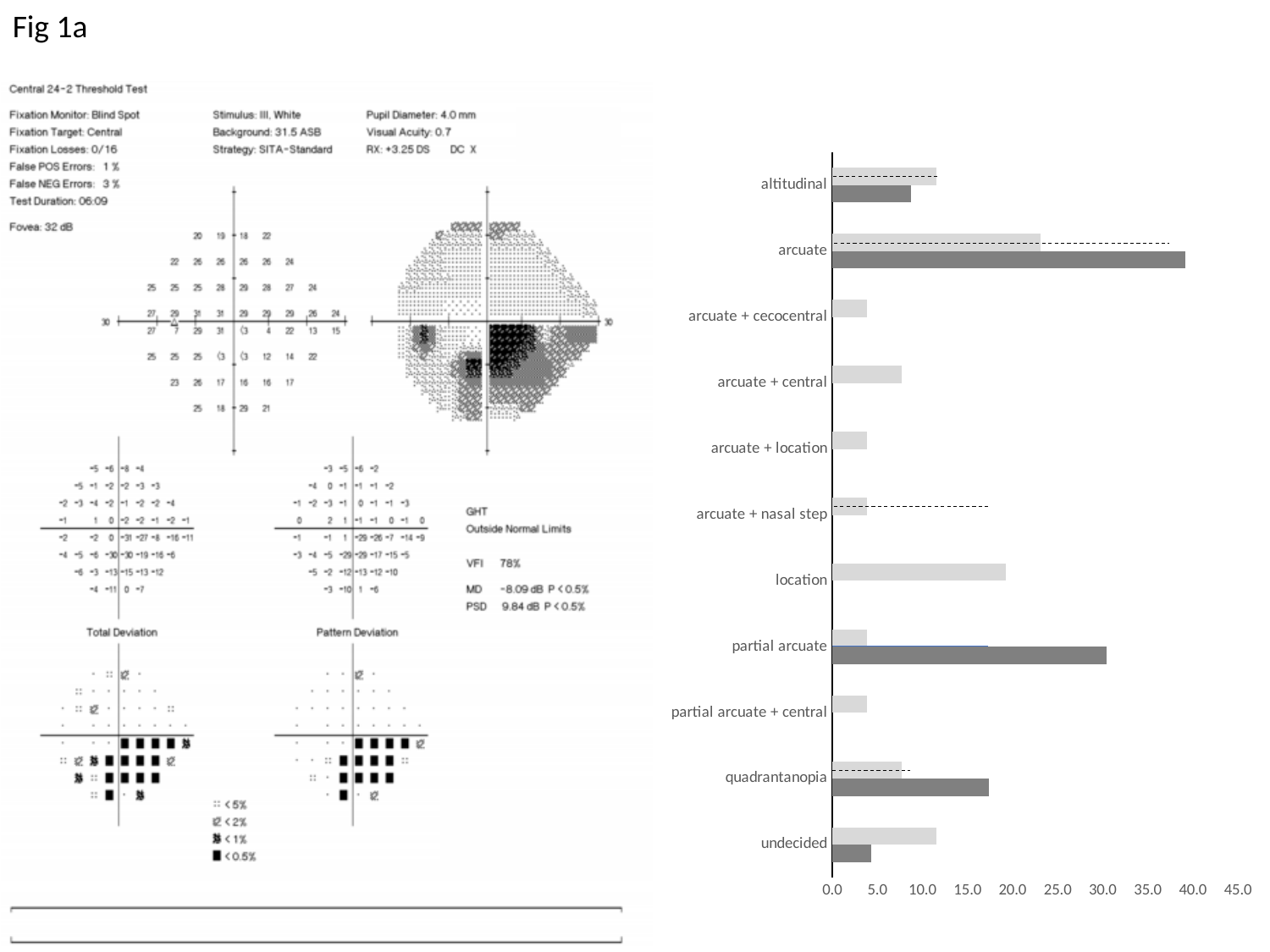
In the bar chart, which has the longer dark grey bar: arcuate or partial arcuate? arcuate In the bar chart, is the dark grey value for undecided greater or less than 10.0? less How many categories are listed on the vertical axis of the bar chart? 11 What kind of chart is shown on the right side of the slide? bar chart In the bar chart, is the dark grey value for arcuate greater or less than 35.0? greater What is the highest tick value shown on the horizontal axis of the bar chart? 45.0 In the bar chart, which category has the longest bar overall? arcuate In the bar chart, is the light grey value for arcuate + cecocentral greater or less than 10.0? less In the bar chart, which has the longer light grey bar: location or altitudinal? location In the bar chart, which category has the longest light grey bar? arcuate